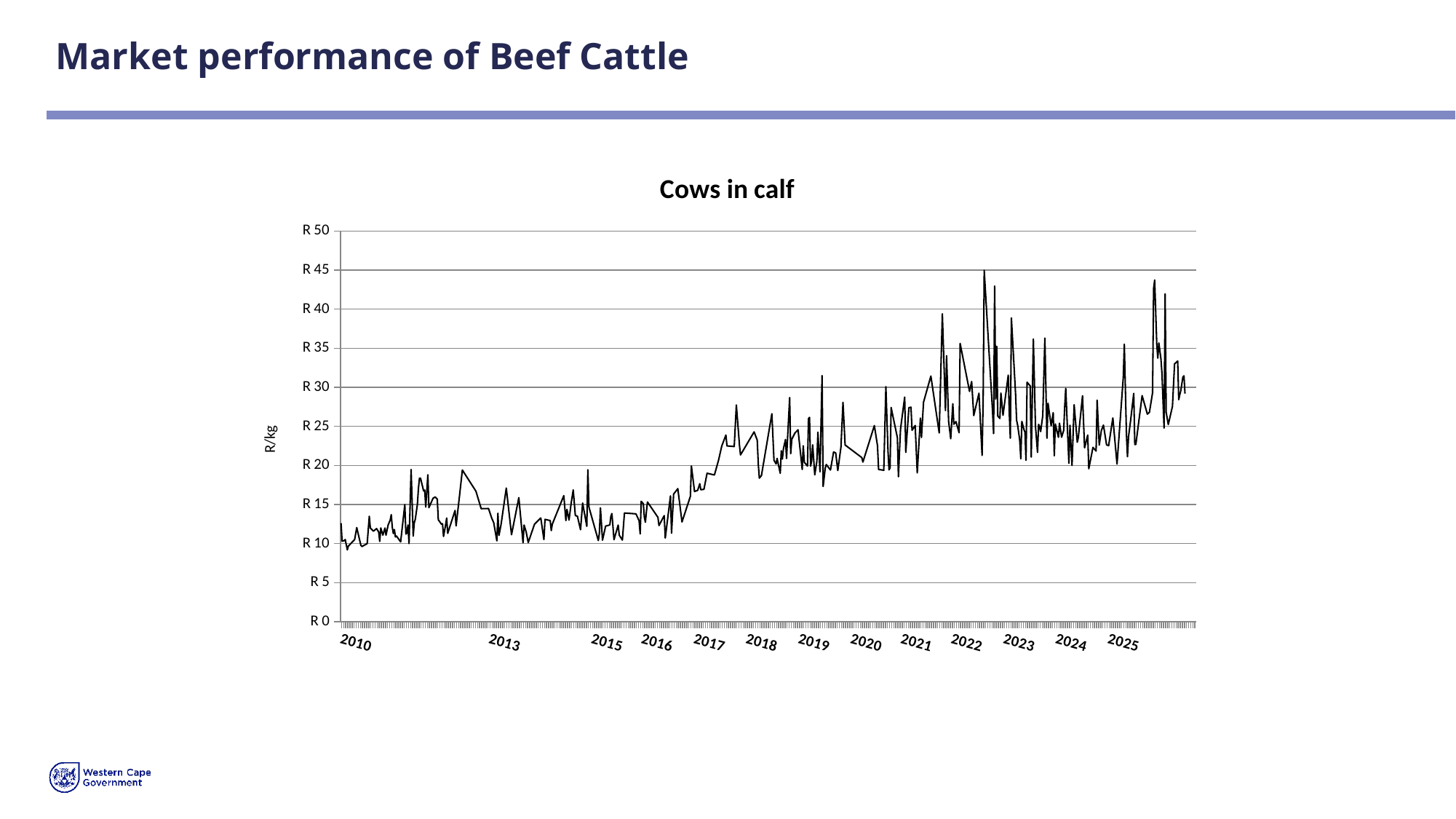
What is the title of the chart? Cows in calf Is the highest peak of the line, around 2022, greater or less than R 40? greater Are the values during 2025 greater or less than R 20? greater What is the highest value shown on the vertical axis? R 50 Is the value at the start of 2016 greater or less than R 20? less Around which year does the line reach its lowest point? 2010 Are the values generally higher in 2024 or in 2013? 2024 Overall, do the values rise or fall from 2010 to 2025? rise What is the first year label shown on the horizontal axis? 2010 What kind of chart is shown on the slide? line chart What is the label on the vertical axis of the chart? R/kg